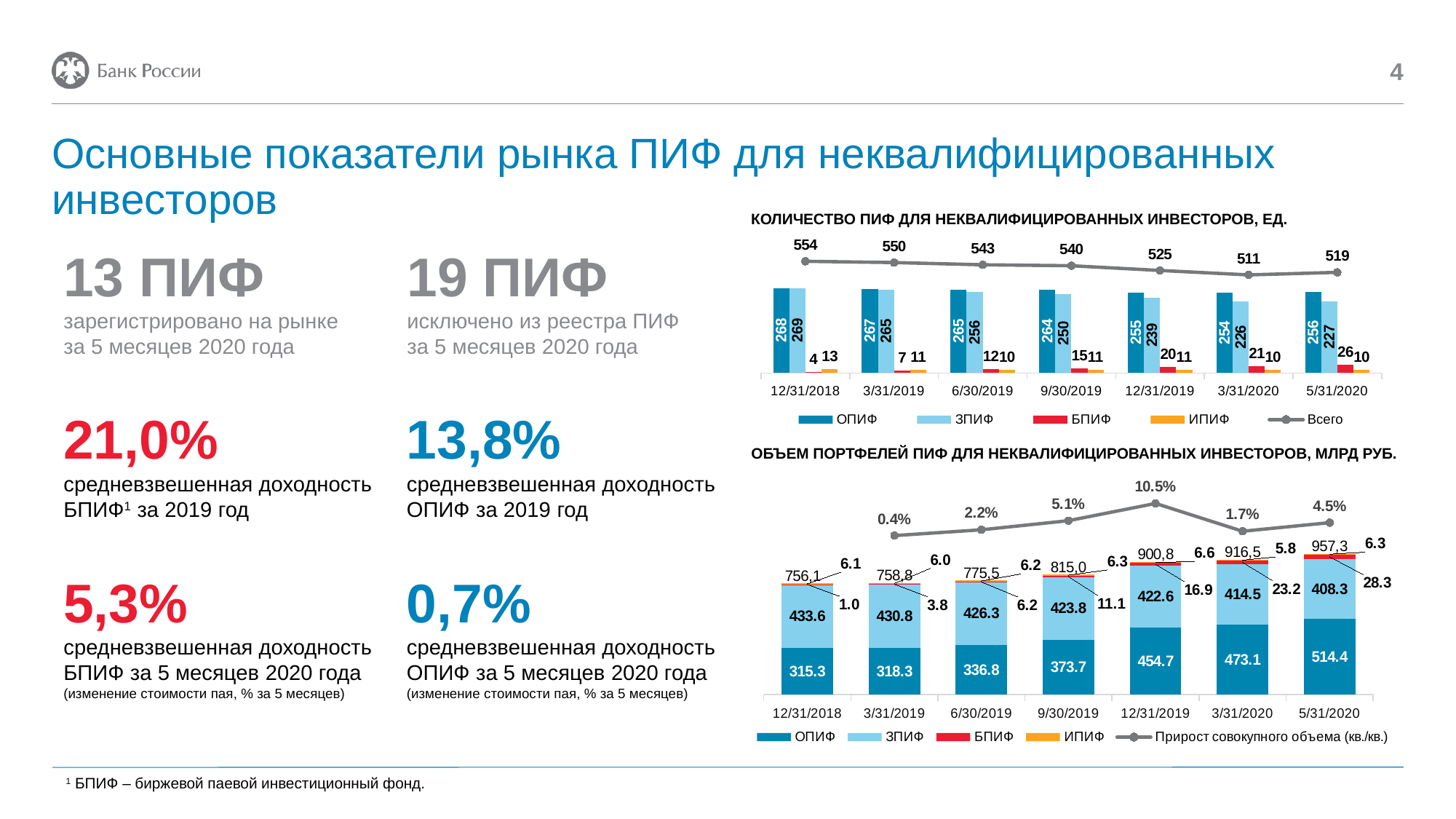
What kind of chart is 'ОБЪЕМ ПОРТФЕЛЕЙ ПИФ ДЛЯ НЕКВАЛИФИЦИРОВАННЫХ ИНВЕСТОРОВ, МЛРД РУБ.'? Stacked bar chart with a line In the chart 'ОБЪЕМ ПОРТФЕЛЕЙ ПИФ ДЛЯ НЕКВАЛИФИЦИРОВАННЫХ ИНВЕСТОРОВ, МЛРД РУБ.', how many dates are shown on the x axis? 7 In the chart 'КОЛИЧЕСТВО ПИФ ДЛЯ НЕКВАЛИФИЦИРОВАННЫХ ИНВЕСТОРОВ, ЕД.', what is the value of БПИФ on 5/31/2020? 26 In the chart 'ОБЪЕМ ПОРТФЕЛЕЙ ПИФ ДЛЯ НЕКВАЛИФИЦИРОВАННЫХ ИНВЕСТОРОВ, МЛРД РУБ.', what is the value of ОПИФ on 5/31/2020? 514.4 In the chart 'КОЛИЧЕСТВО ПИФ ДЛЯ НЕКВАЛИФИЦИРОВАННЫХ ИНВЕСТОРОВ, ЕД.', does the ЗПИФ series rise or fall from 12/31/2018 to 3/31/2020? fall In the chart 'КОЛИЧЕСТВО ПИФ ДЛЯ НЕКВАЛИФИЦИРОВАННЫХ ИНВЕСТОРОВ, ЕД.', on which date is Всего lowest? 3/31/2020 In the chart 'ОБЪЕМ ПОРТФЕЛЕЙ ПИФ ДЛЯ НЕКВАЛИФИЦИРОВАННЫХ ИНВЕСТОРОВ, МЛРД РУБ.', which is larger on 12/31/2018: ОПИФ or ЗПИФ? ЗПИФ In the chart 'ОБЪЕМ ПОРТФЕЛЕЙ ПИФ ДЛЯ НЕКВАЛИФИЦИРОВАННЫХ ИНВЕСТОРОВ, МЛРД РУБ.', what is the total of the stacked bar on 12/31/2019? 900,8 In the chart 'КОЛИЧЕСТВО ПИФ ДЛЯ НЕКВАЛИФИЦИРОВАННЫХ ИНВЕСТОРОВ, ЕД.', what is the difference between ОПИФ and ЗПИФ on 5/31/2020? 29 In the chart 'КОЛИЧЕСТВО ПИФ ДЛЯ НЕКВАЛИФИЦИРОВАННЫХ ИНВЕСТОРОВ, ЕД.', what is the value of Всего on 12/31/2018? 554 In the chart 'ОБЪЕМ ПОРТФЕЛЕЙ ПИФ ДЛЯ НЕКВАЛИФИЦИРОВАННЫХ ИНВЕСТОРОВ, МЛРД РУБ.', on which date is the growth line 'Прирост совокупного объема (кв./кв.)' highest? 12/31/2019 In the chart 'КОЛИЧЕСТВО ПИФ ДЛЯ НЕКВАЛИФИЦИРОВАННЫХ ИНВЕСТОРОВ, ЕД.', how many series does the legend list? 5